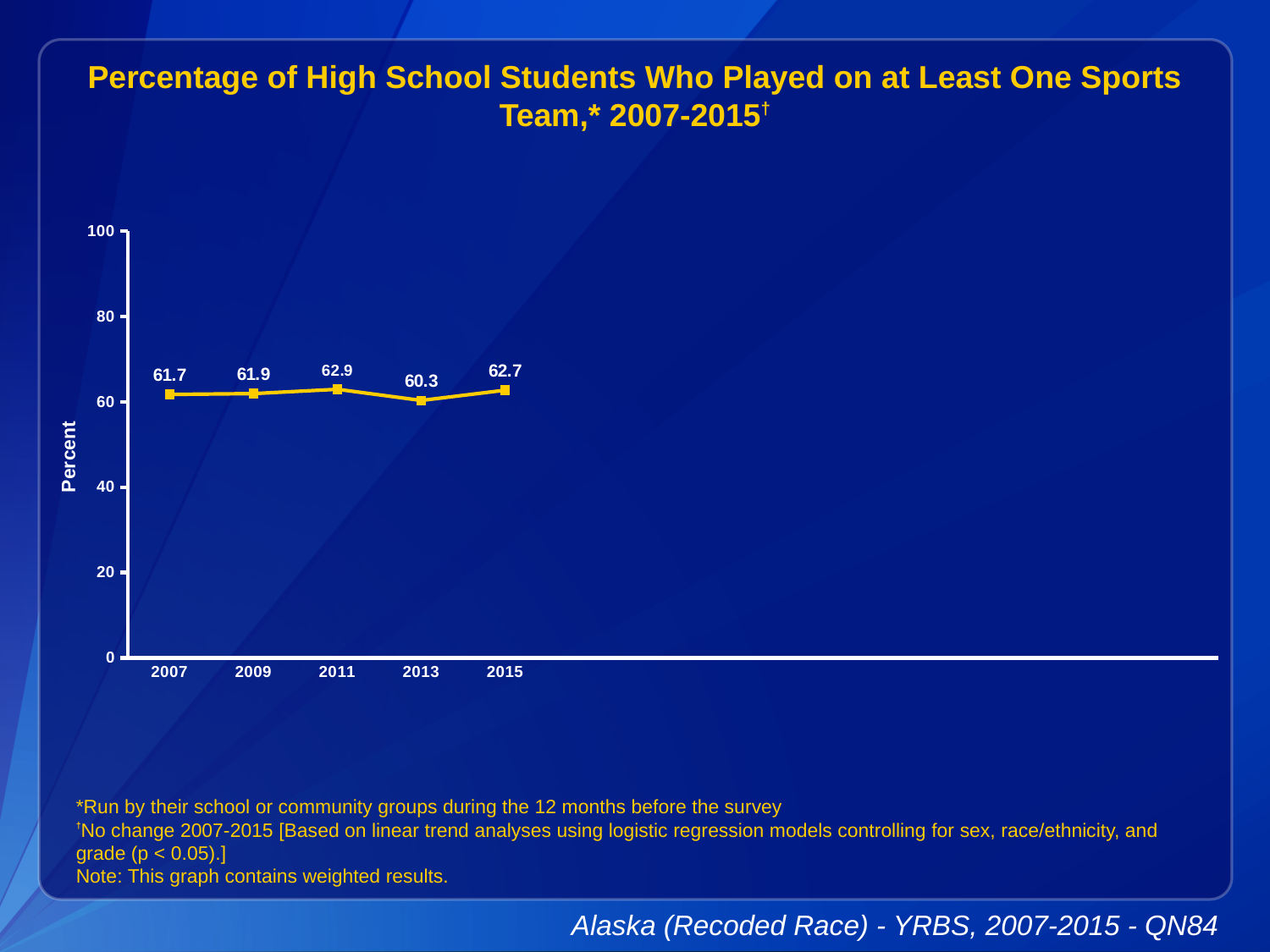
What is the value plotted for 2015? 62.7 What kind of chart is shown on the slide? line chart Is the value for 2015 greater or less than 60? greater What is the value plotted for 2013? 60.3 What percentage of high school students played on at least one sports team in 2007? 61.7 Which year has the highest percentage? 2011 Which year has the lowest percentage? 2013 What is the maximum value shown on the y axis? 100 What is the label on the y axis? Percent What is the difference between the 2011 value and the 2013 value? 2.6 Which is larger, the value for 2009 or the value for 2013? 2009 How many years are plotted on the x axis? 5